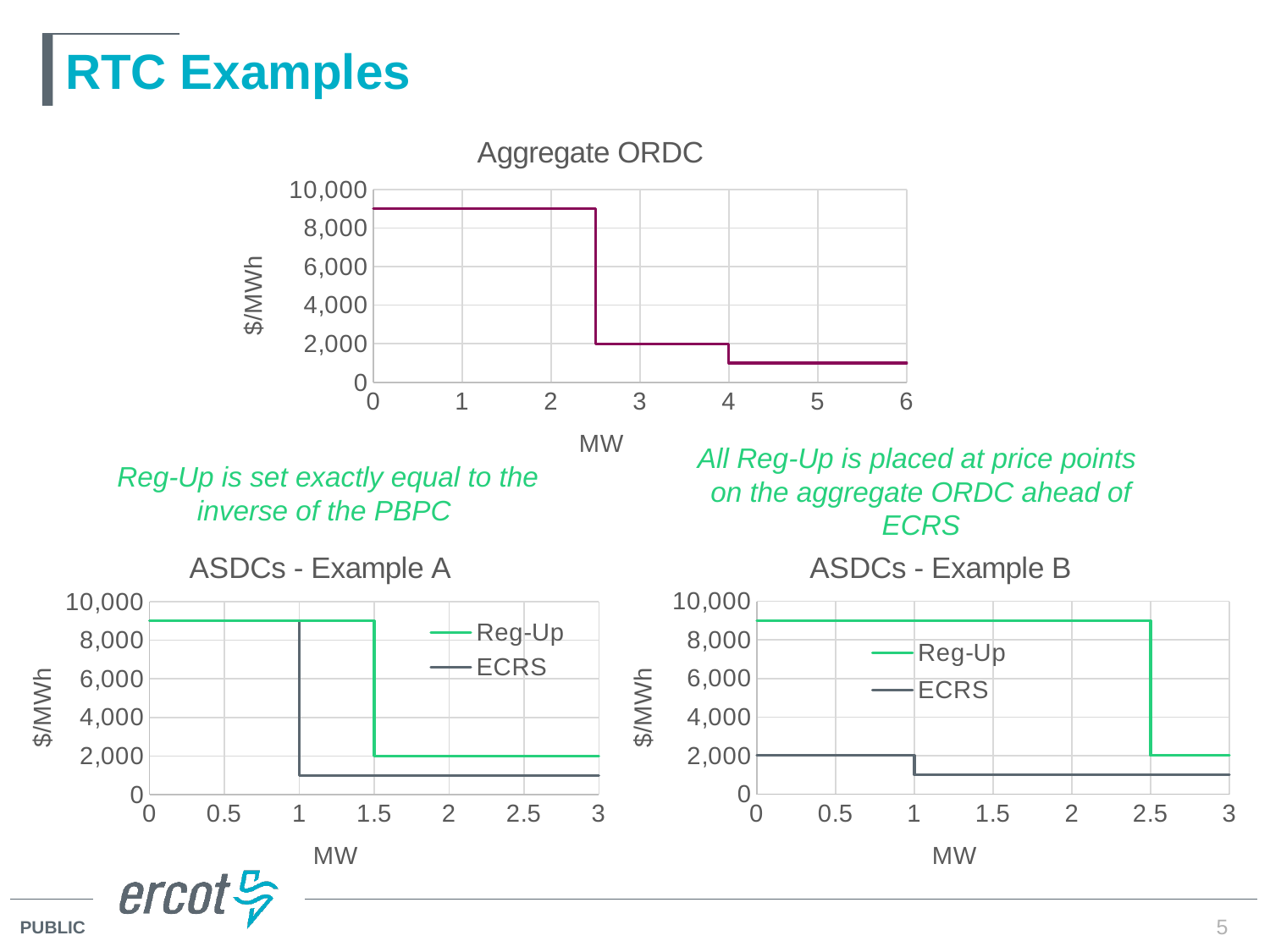
In the Aggregate ORDC chart, what is the $/MWh value at 3 MW? 2,000 In the ASDCs - Example B chart, what is the ECRS value at 0.5 MW? 2,000 In the Aggregate ORDC chart, is the value at 1 MW greater or less than 8,000? greater In the Aggregate ORDC chart, does the price rise or fall as MW increases? fall In the ASDCs - Example B chart, at what MW value does the Reg-Up line step down? 2.5 In the ASDCs - Example B chart, which series has the larger value at 2 MW, Reg-Up or ECRS? Reg-Up What kind of chart is the Aggregate ORDC chart? line chart In the ASDCs - Example A chart, how many series does the legend list? 2 In the Aggregate ORDC chart, at what MW value does the curve step down to its lowest level? 4 In the Aggregate ORDC chart, is the value at 5 MW greater or less than 2,000? less In the ASDCs - Example A chart, at what MW value does the Reg-Up line step down? 1.5 In the ASDCs - Example B chart, what are the two legend entries? Reg-Up and ECRS